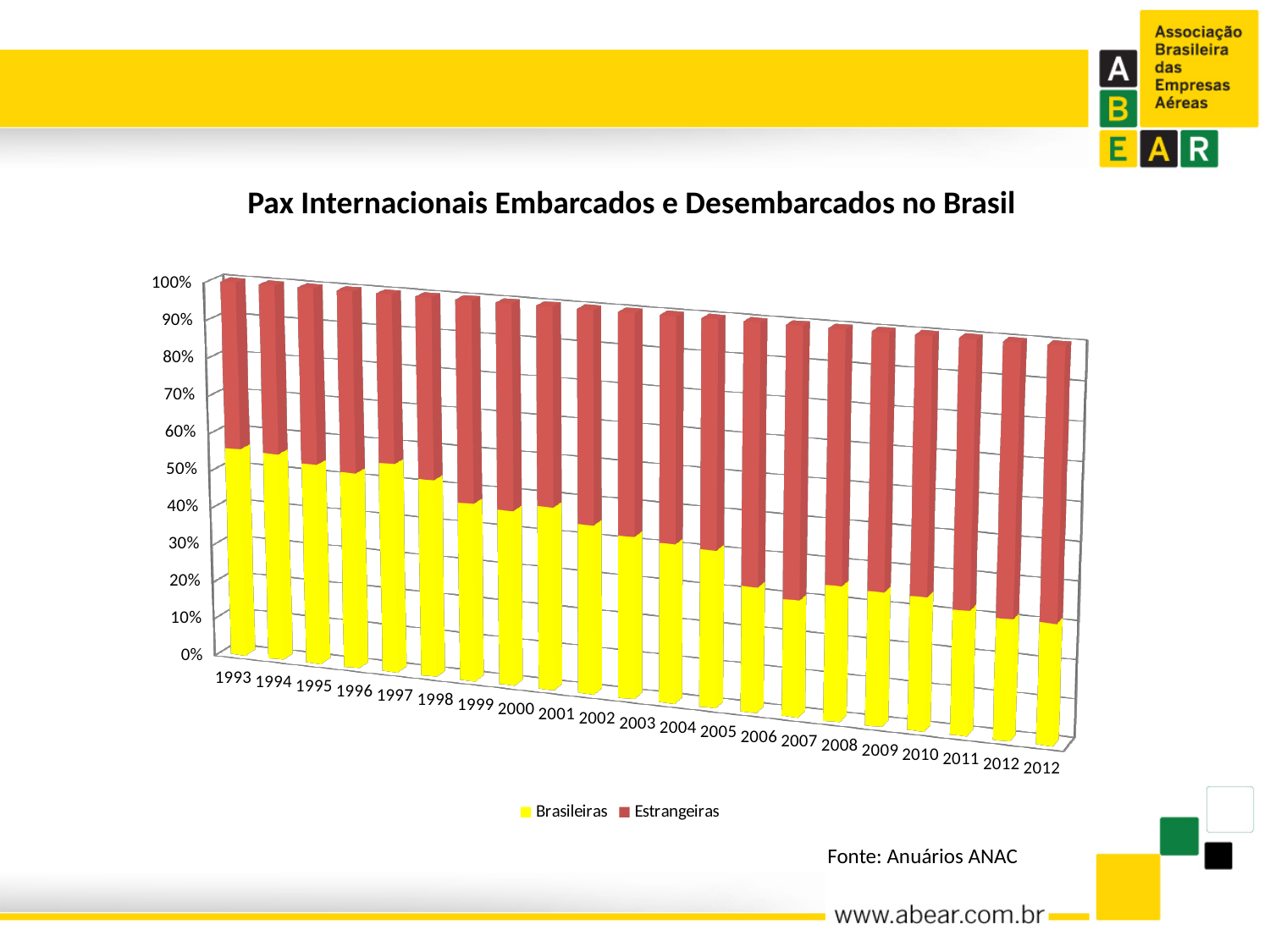
How many bars are plotted along the x axis? 21 Is the share for Brasileiras in 1993 greater or less than 40%? greater Does the share of Brasileiras rise or fall from 1993 to 2012? Fall Which series is shown in yellow? Brasileiras What kind of chart is shown on the slide? Stacked bar chart How many series does the legend list? 2 What is the title of the chart? Pax Internacionais Embarcados e Desembarcados no Brasil In 2012, which series has the larger share, Brasileiras or Estrangeiras? Estrangeiras Which year has the highest share for Brasileiras? 1993